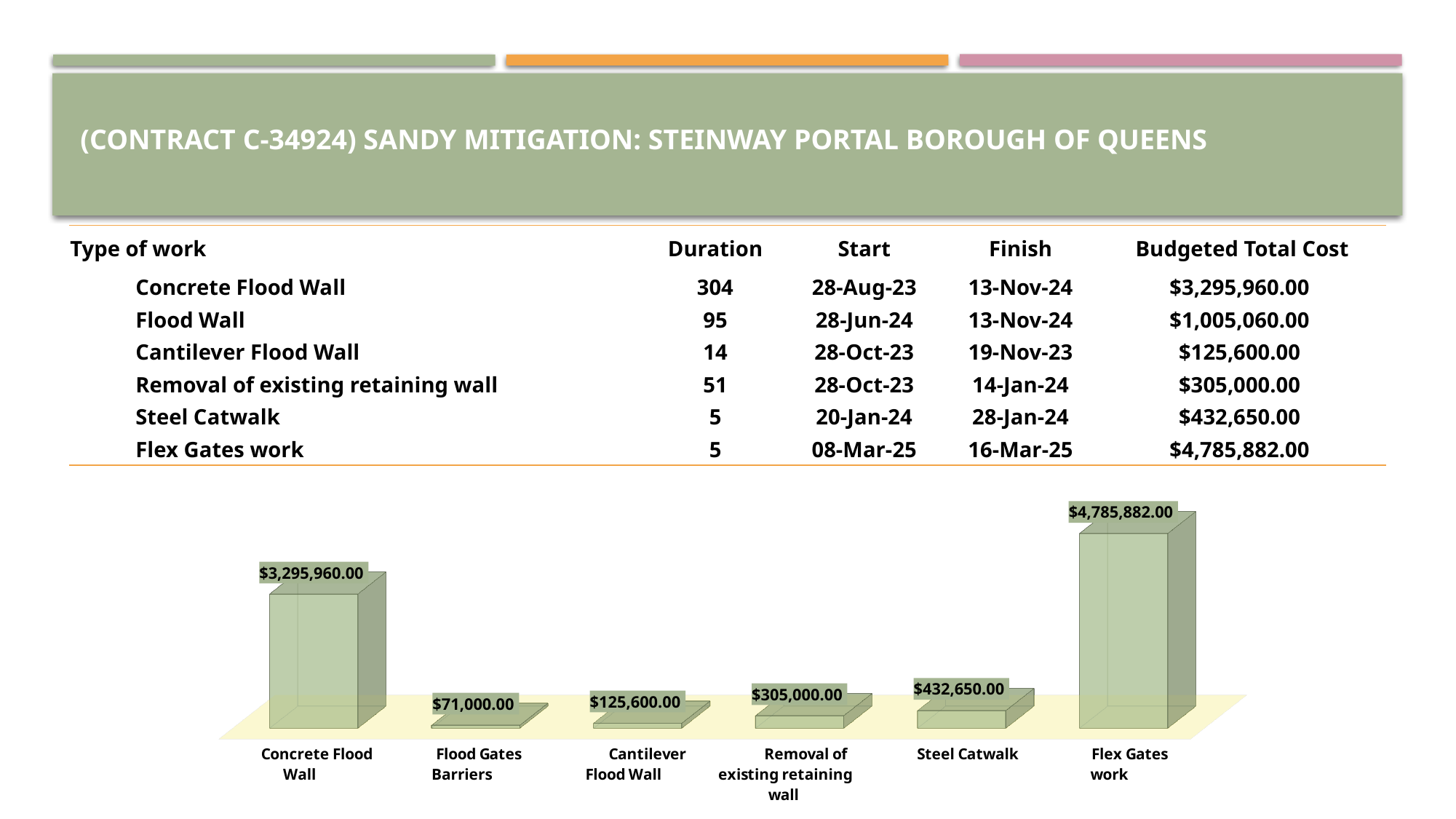
Which is larger in the chart: Cantilever Flood Wall or Steel Catwalk? Steel Catwalk What is the value shown for Removal of existing retaining wall in the chart? $305,000.00 What is the value shown for Steel Catwalk in the chart? $432,650.00 What is the difference between the values for Steel Catwalk and Removal of existing retaining wall in the chart? $127,650.00 Which category has the lowest value in the chart? Flood Gates Barriers What is the value shown for Flood Gates Barriers in the chart? $71,000.00 How many bars (categories) does the chart show? 6 What is the title of the slide containing the chart? (CONTRACT C-34924) SANDY MITIGATION: STEINWAY PORTAL BOROUGH OF QUEENS What is the difference between the values for Flex Gates work and Concrete Flood Wall in the chart? $1,489,922.00 What is the value shown for Concrete Flood Wall in the chart? $3,295,960.00 What type of chart is shown on the slide? Bar chart Which category has the highest value in the chart? Flex Gates work